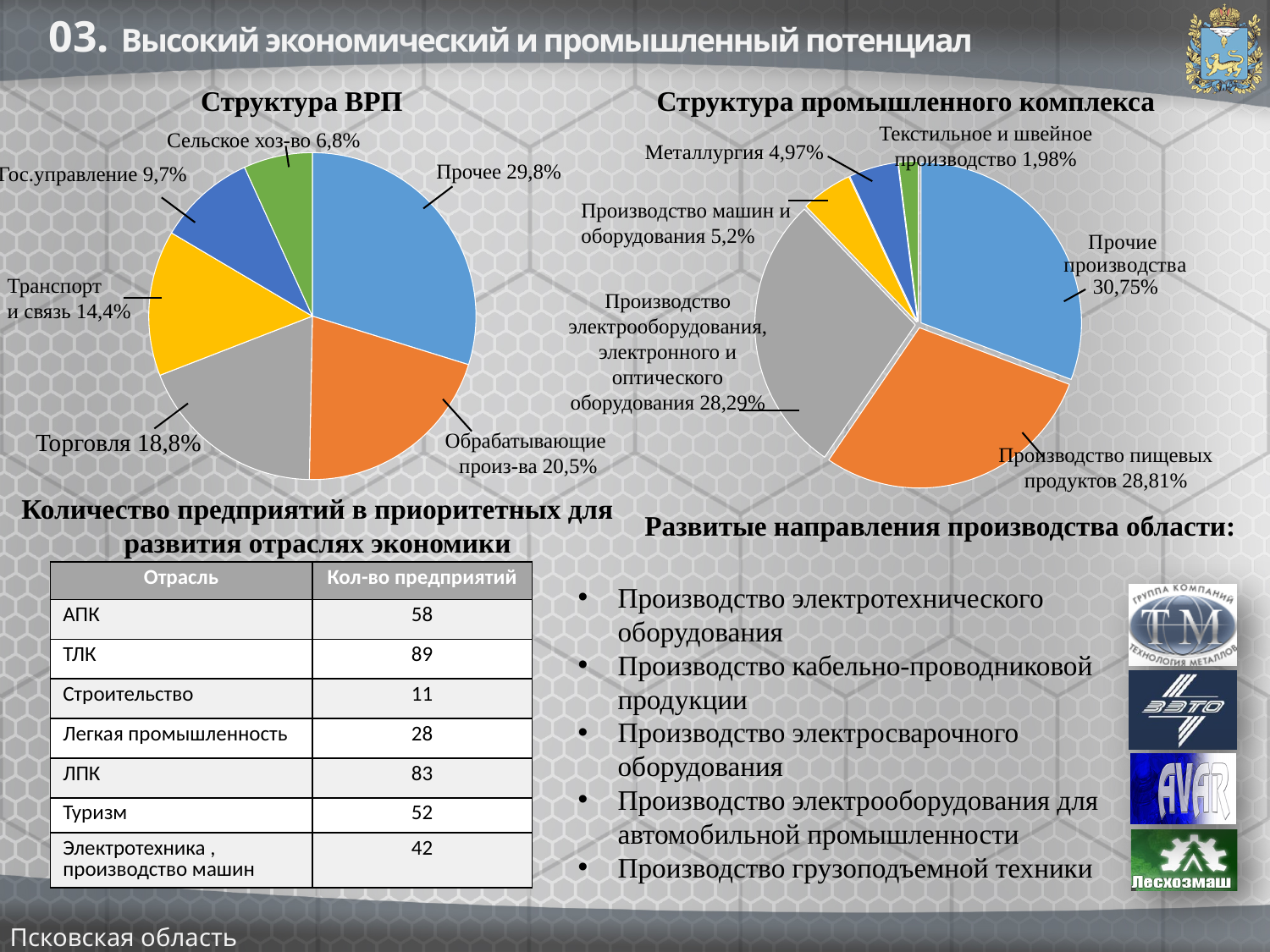
In the chart titled "Структура промышленного комплекса", which category has the smallest share? Текстильное и швейное производство In the chart titled "Структура ВРП", how many slices does the pie have? 6 In the chart titled "Структура ВРП", what is the difference between the shares of "Обрабатывающие произ-ва" and "Транспорт и связь"? 6,1% In the chart titled "Структура промышленного комплекса", which category has the largest share? Прочие производства In the chart titled "Структура ВРП", which category has the largest share? Прочее In the chart titled "Структура ВРП", which category has the smallest share? Сельское хоз-во In the chart titled "Структура ВРП", what colour is the "Сельское хоз-во" slice? Green In the chart titled "Структура промышленного комплекса", which is larger: "Производство машин и оборудования" or "Металлургия"? Производство машин и оборудования In the chart titled "Структура ВРП", what share does "Торговля" have? 18,8% What kind of chart is "Структура ВРП"? Pie chart In the chart titled "Структура промышленного комплекса", what is the difference between the shares of "Производство пищевых продуктов" and "Производство электрооборудования, электронного и оптического оборудования"? 0,52% In the chart titled "Структура промышленного комплекса", what share does "Металлургия" have? 4,97%